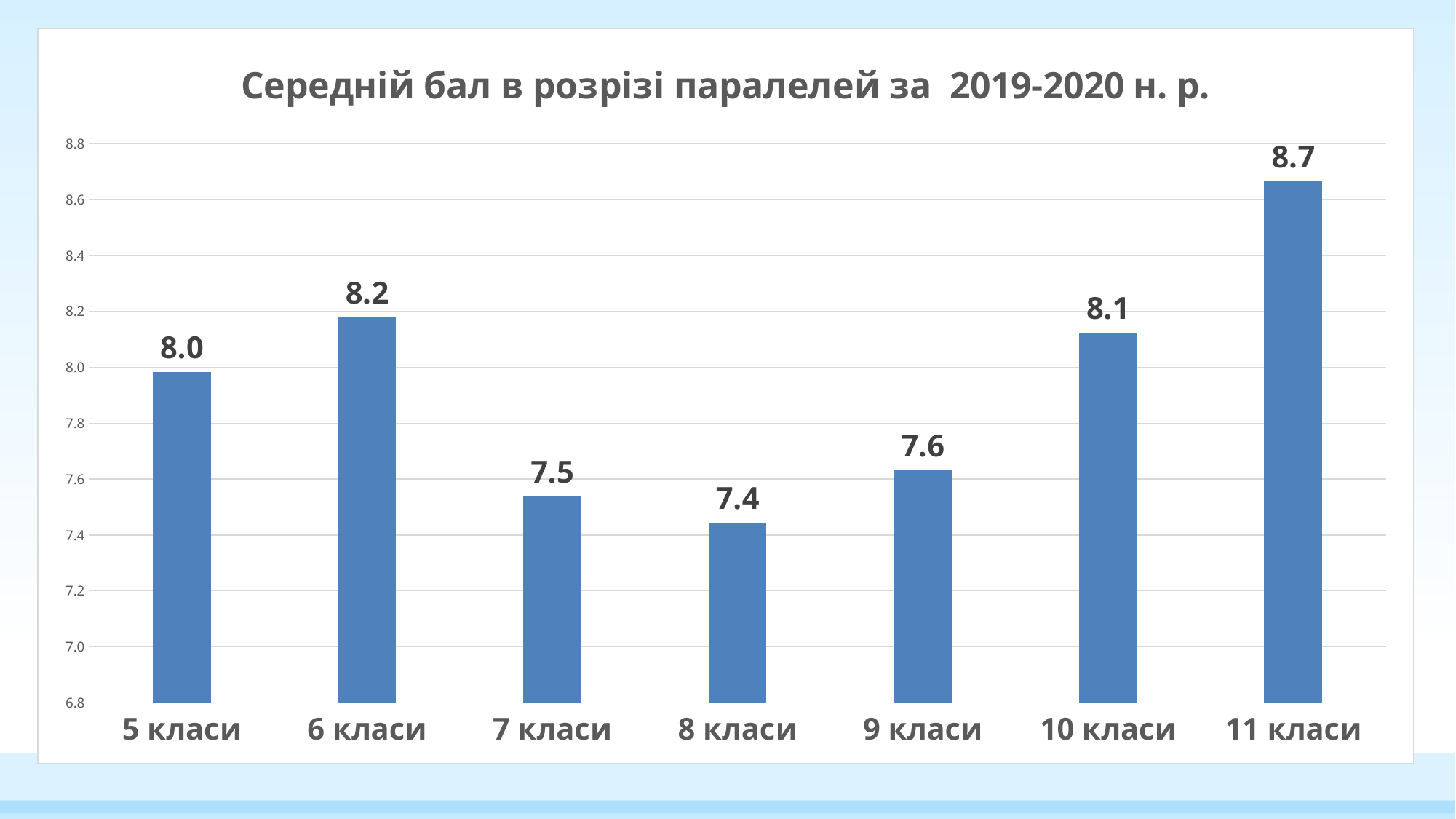
Which class parallel has the highest average score? 11 класи What is the average score for 10 класи? 8.1 Which has a higher average score, 6 класи or 9 класи? 6 класи Which class parallel has the lowest average score? 8 класи How many class parallels are shown on the chart? 7 What kind of chart is shown on the slide? bar chart What is the average score for 5 класи? 8.0 Do the values rise or fall from 8 класи to 11 класи? rise Is the value for 7 класи greater or less than 7.6? less What is the title of the chart? Середній бал в розрізі паралелей за 2019-2020 н. р. What is the difference between the average scores of 11 класи and 8 класи? 1.3 What is the average score for 8 класи? 7.4